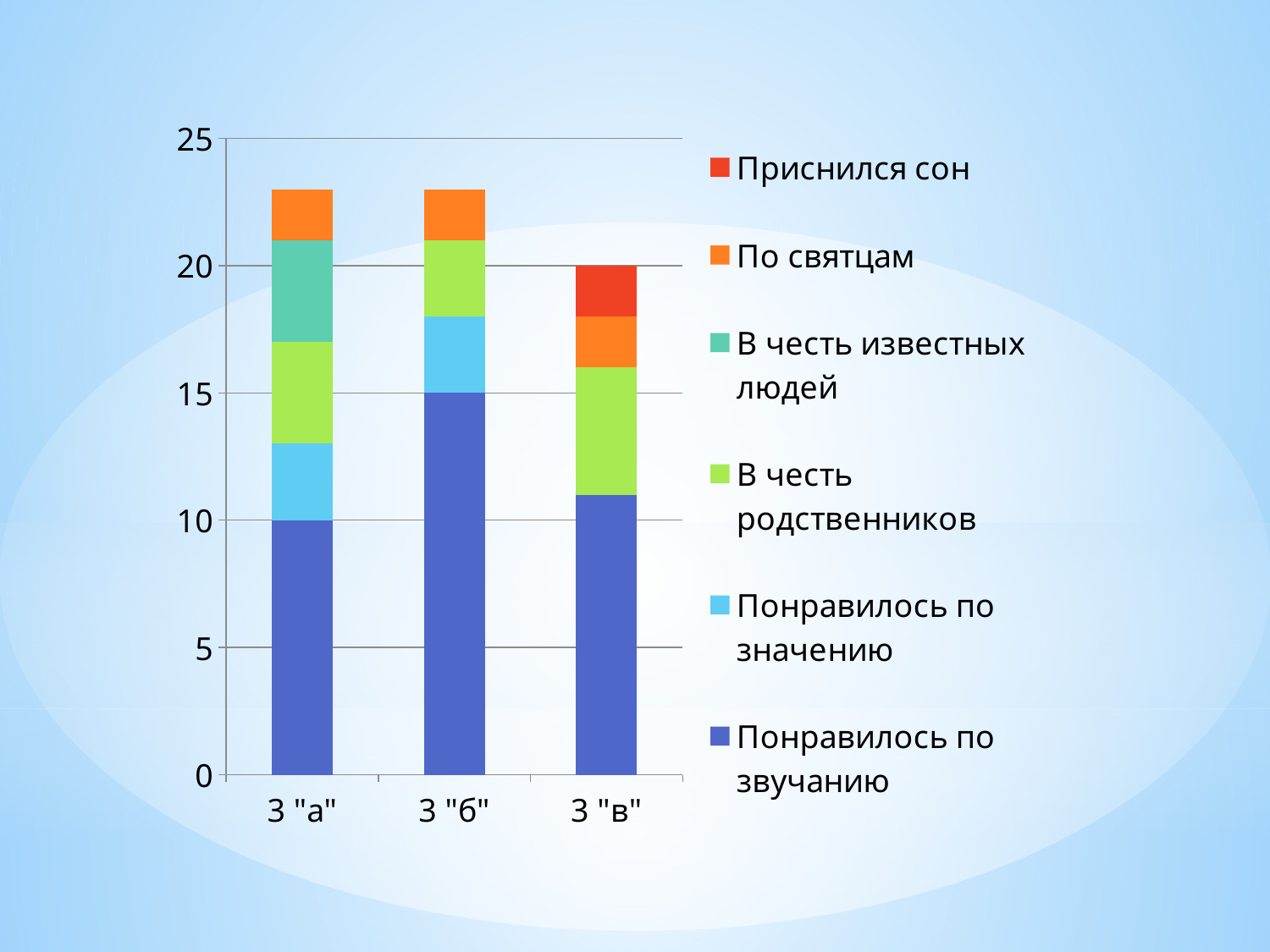
Which series is listed first (at the top) in the legend? Приснился сон What is the value of "Понравилось по звучанию" for 3 "а"? 10 What is the total height of the stacked bar for 3 "в"? 20 Is the value of "Понравилось по звучанию" for 3 "в" greater or less than 10? greater Is the total stacked bar for 3 "а" greater or less than 20? greater What is the value of "Понравилось по звучанию" for 3 "б"? 15 How many categories are shown on the x axis? 3 How many series does the legend list? 6 Which category has the lowest total stacked bar? 3 "в" What kind of chart is shown on the slide? Stacked bar chart Which category is the only one with a "Приснился сон" segment? 3 "в" Which is larger, the "Понравилось по звучанию" value for 3 "а" or for 3 "б"? 3 "б"